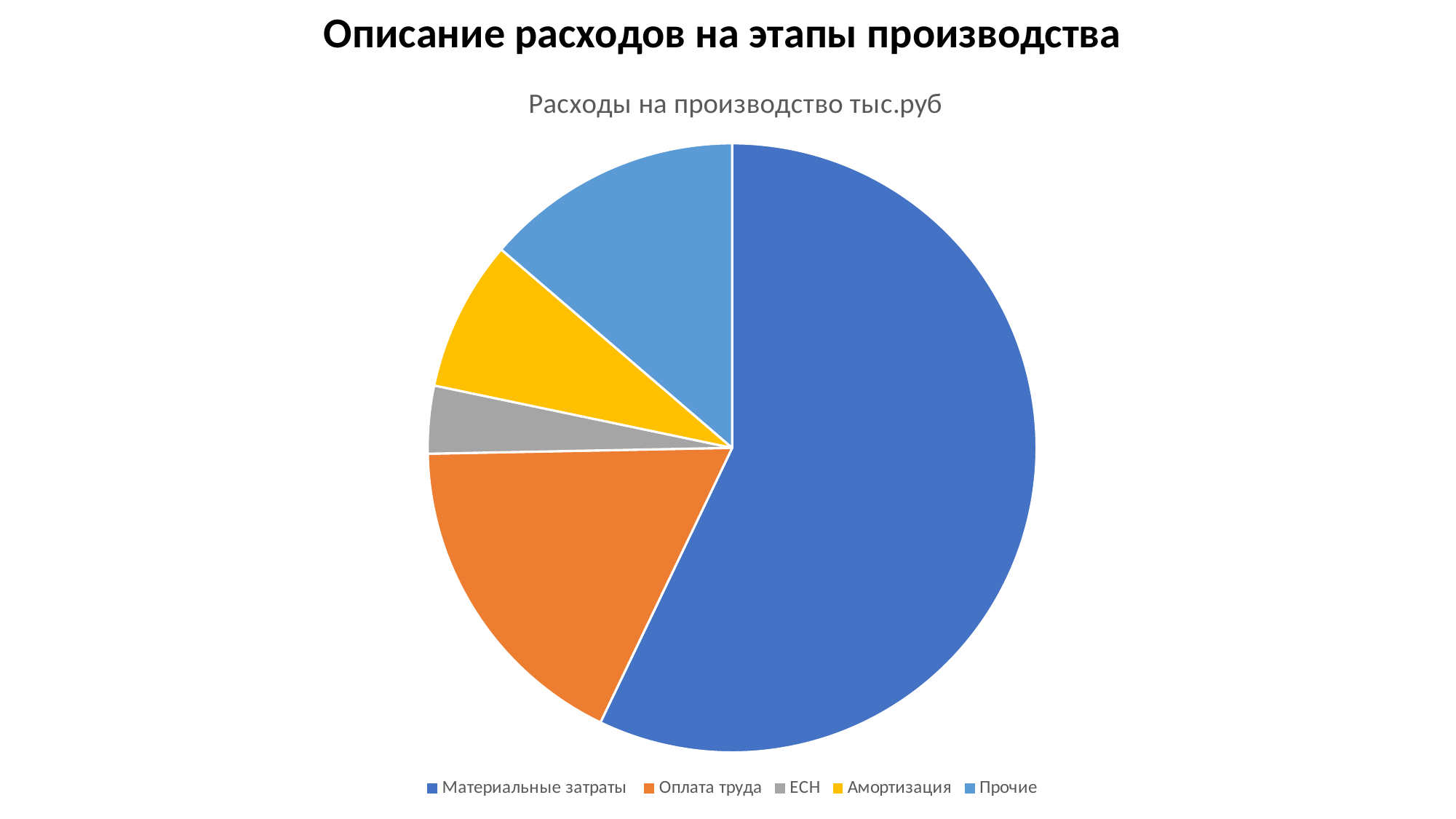
Which slice is larger, Материальные затраты or Оплата труда? Материальные затраты How many categories does the legend of the pie chart list? 5 What kind of chart is shown on the slide? pie chart Which category is shown in orange in the pie chart? Оплата труда How many slices does the pie chart have? 5 Which slice is larger, ЕСН or Амортизация? Амортизация What is the title of the chart? Расходы на производство тыс.руб Which category has the smallest slice of the pie? ЕСН Which slice is larger, Амортизация or Прочие? Прочие Which category has the largest slice of the pie? Материальные затраты